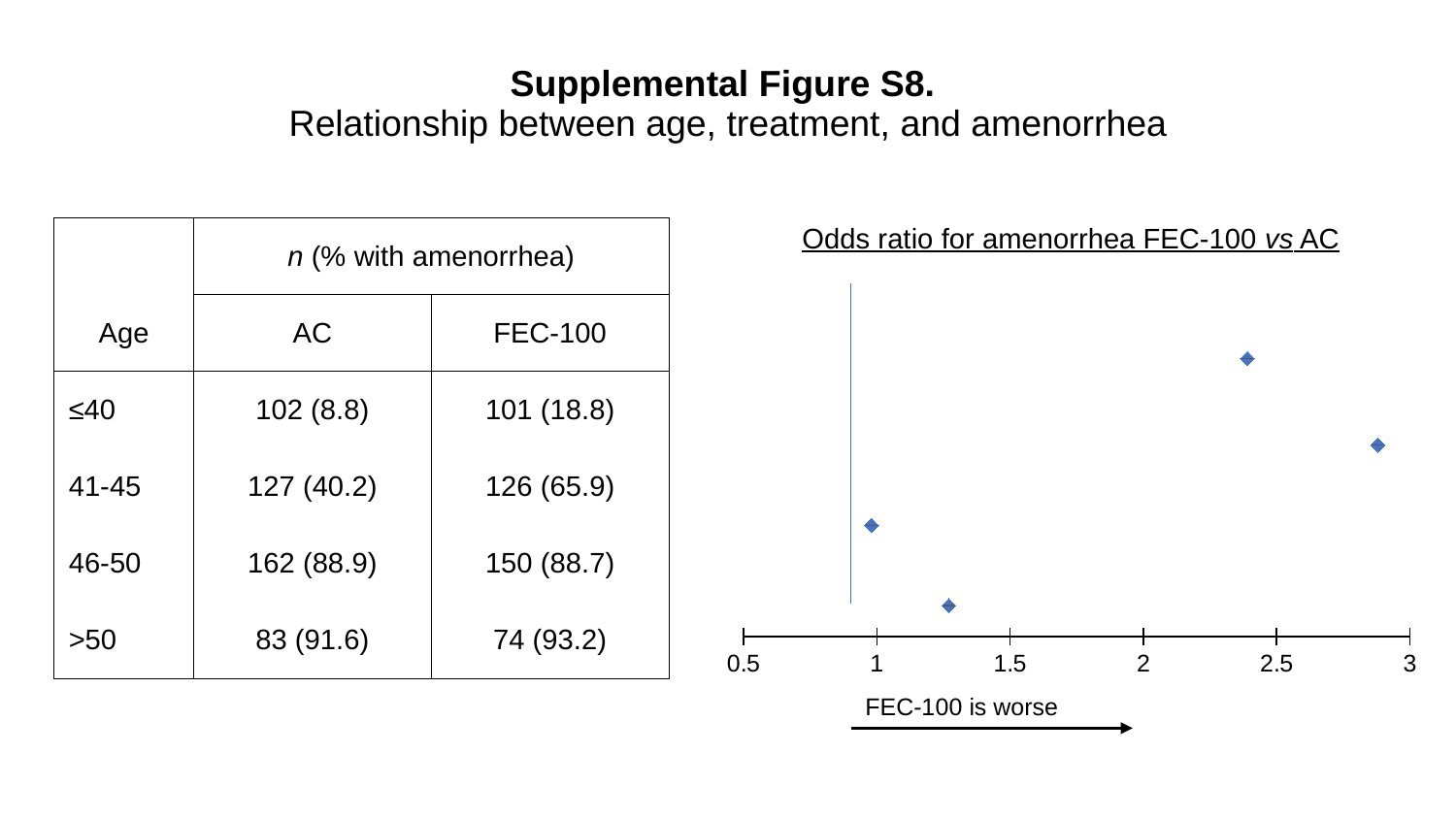
In the odds ratio chart, is the value of the lowest point greater or less than 1.5? less In the odds ratio chart, which has the larger odds ratio: the topmost point or the lowest point? the topmost point What is the title of the chart on the right? Odds ratio for amenorrhea FEC-100 vs AC In the odds ratio chart, is the value of the topmost point greater or less than 2? greater What kind of chart is shown on the right of the slide? scatter plot What are the minimum and maximum tick values shown on the x axis of the odds ratio chart? 0.5 and 3 In the odds ratio chart, is the value of the point closest to the vertical reference line greater or less than 1.5? less What text is written below the x axis of the odds ratio chart, next to the arrow? FEC-100 is worse How many data points are plotted in the odds ratio chart? 4 In the odds ratio chart, how many points have an odds ratio greater than 2? 2